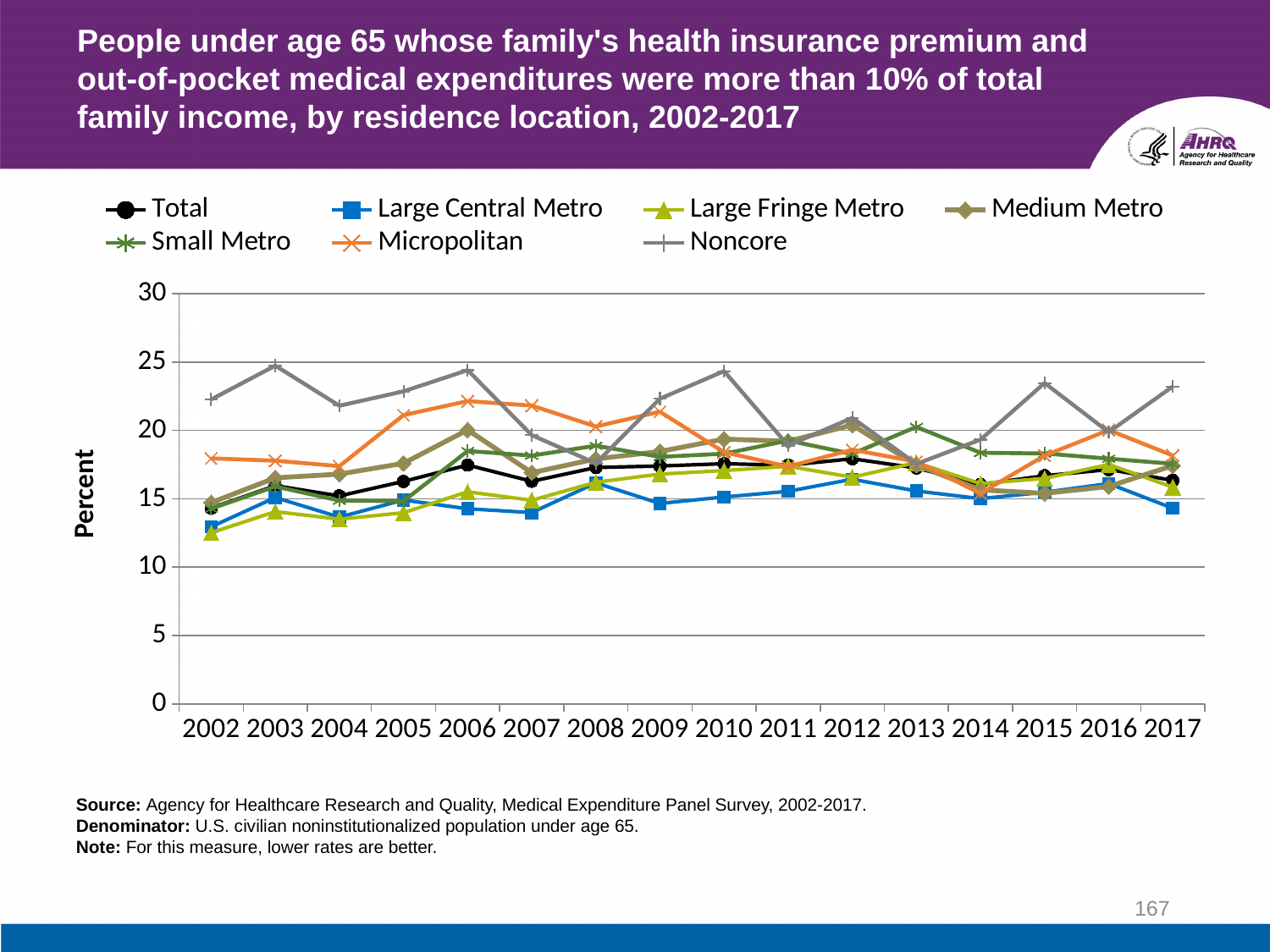
Is the value for Total in 2012 greater or less than 15? greater Does the Noncore line rise or fall from 2002 to 2003? rise What kind of chart is shown on the slide? line chart Is the value for Large Central Metro in 2007 greater or less than 15? less How many years are plotted along the x axis? 16 How many series does the legend list? 7 Is the value for Noncore in 2003 greater or less than 20? greater In 2006, which is larger: the value for Noncore or the value for Micropolitan? Noncore Which residence location has the highest value in 2003? Noncore Which residence location has the lowest value in 2017? Large Central Metro What is the label on the y axis? Percent